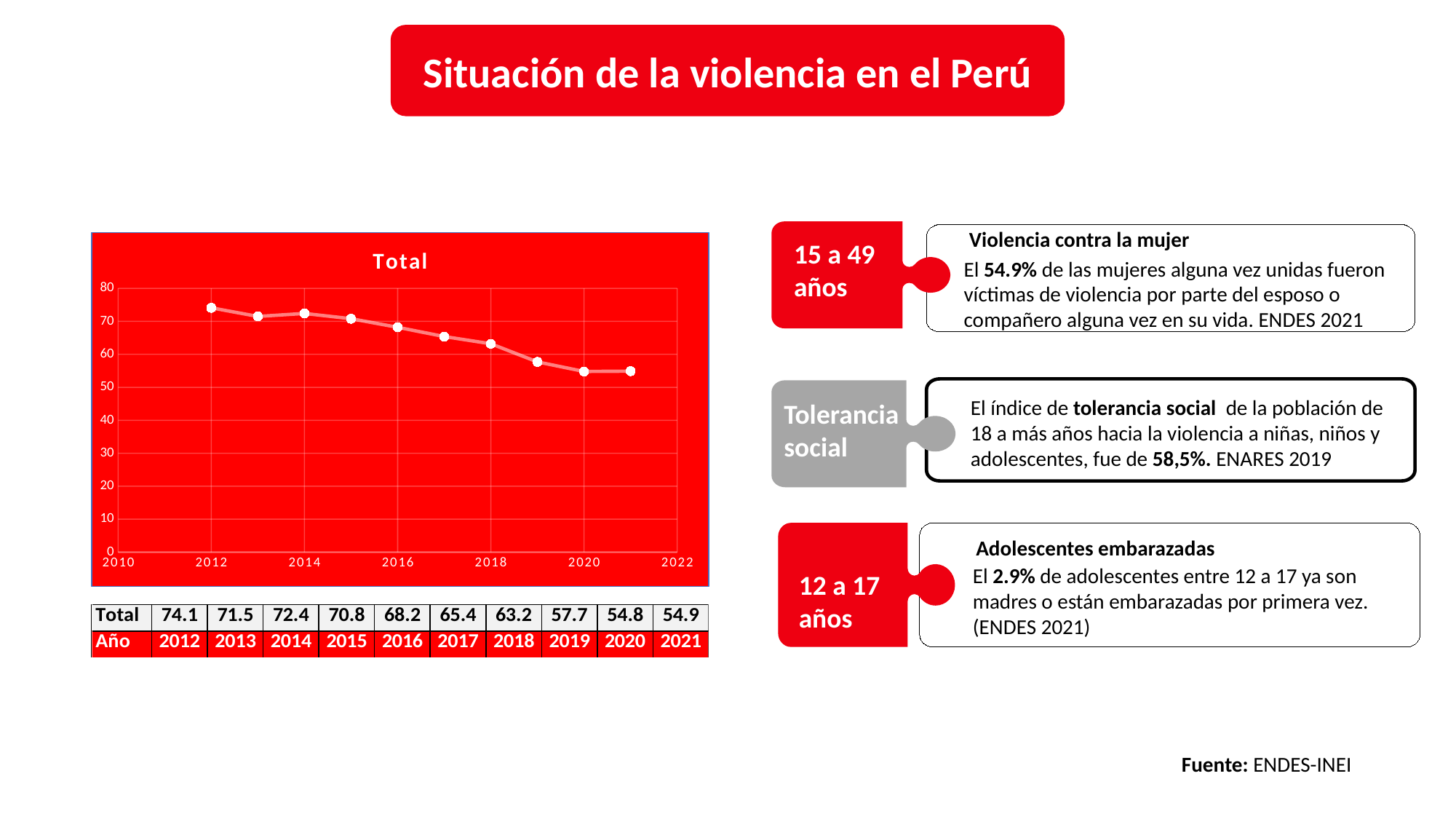
Which year has the lowest Total value? 2020 Which year has the highest Total value? 2012 Is the Total value for 2016 greater or less than 60? greater What is the Total value for 2021? 54.9 Does the Total value generally rise or fall from 2012 to 2021? fall What is the Total value for 2012? 74.1 How many years are plotted in the chart? 10 What is the Total value for 2019? 57.7 What is the difference between the Total values for 2012 and 2021? 19.2 What type of chart is shown on the slide? line chart What is the title of the chart? Total Which is larger, the Total value for 2013 or for 2014? 2014